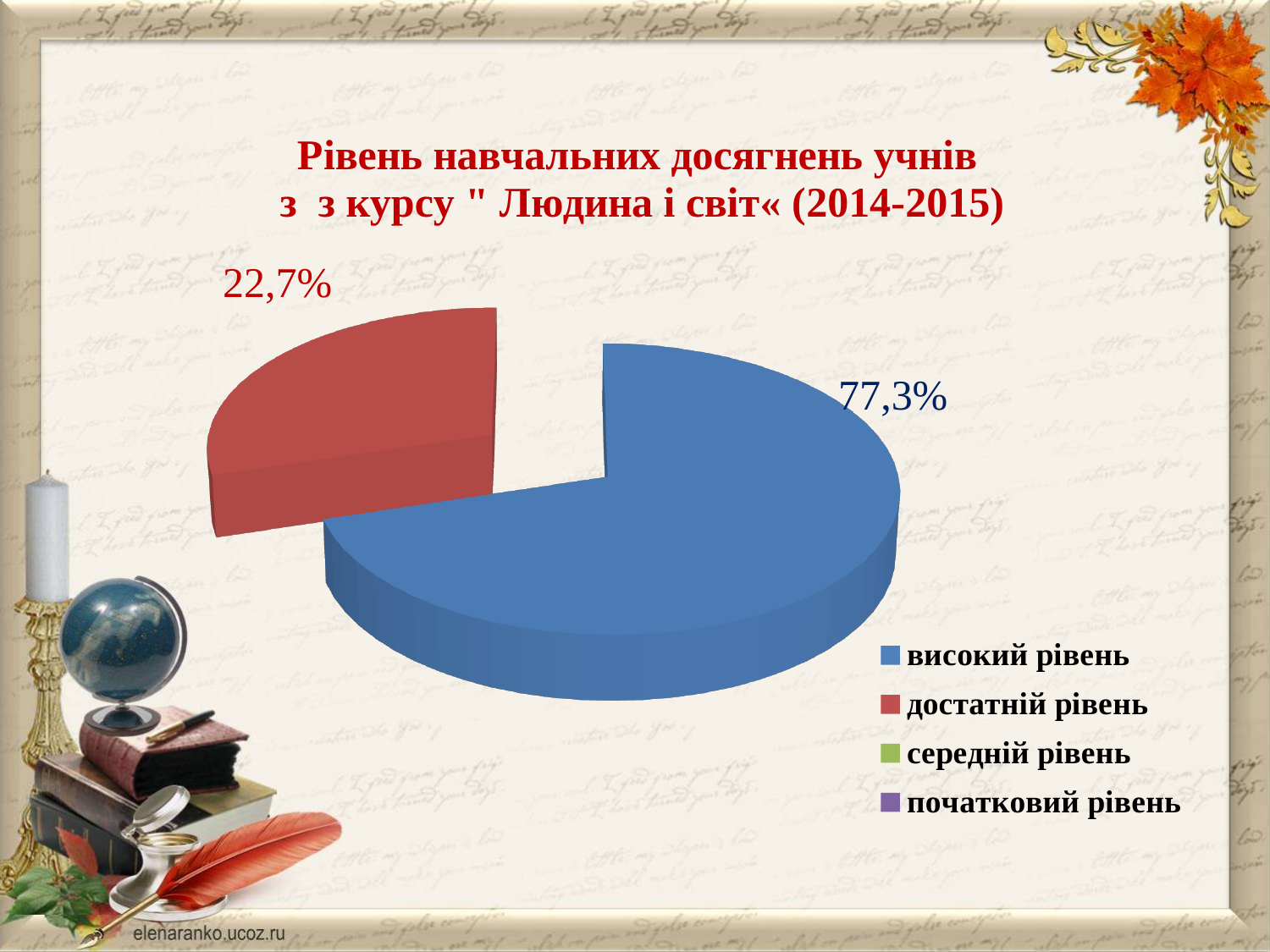
What percentage of the pie chart is labelled for високий рівень? 77,3% What share of the pie does the достатній рівень slice represent? 22,7% What is the difference in percentage points between the високий рівень slice and the достатній рівень slice? 54,6 What percentage of the pie chart is labelled for достатній рівень? 22,7% Which category has the largest slice in the pie chart? високий рівень Which of the two labelled slices in the pie chart is the smallest? достатній рівень How many categories does the legend of the pie chart list? 4 Which school years are given in parentheses in the chart title? 2014-2015 What kind of chart is shown on the slide? pie chart Which slice is larger: високий рівень or достатній рівень? високий рівень How many slices with data labels are visible in the pie chart? 2 What colour is the високий рівень slice in the pie chart? blue